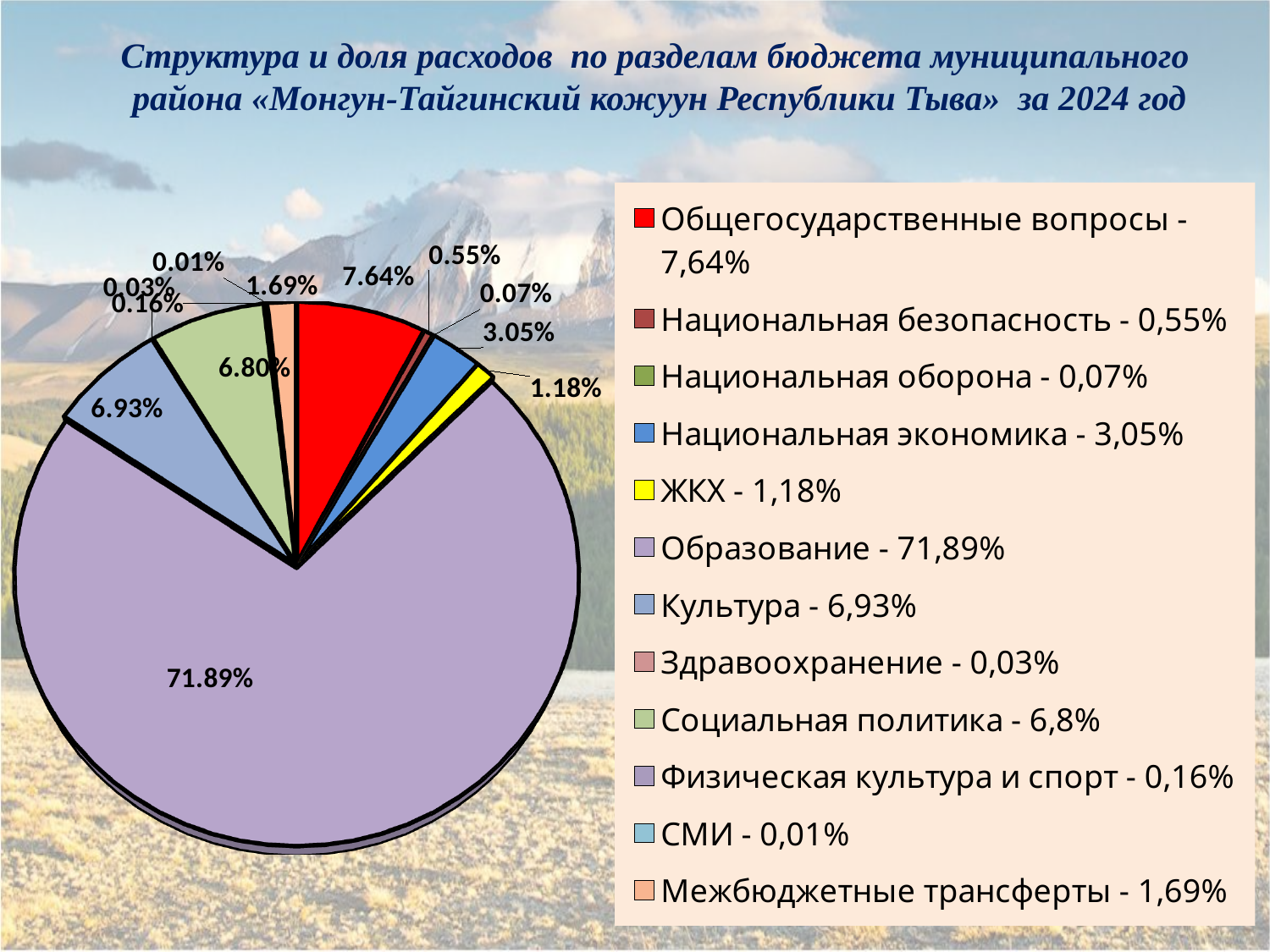
What share of expenditures goes to ЖКХ? 1.18% What is the difference between the shares for Национальная экономика and ЖКХ? 1.87% How many slices (budget sections) does the pie chart have? 12 What share of expenditures goes to Образование? 71.89% What kind of chart is shown on the slide? pie chart By how many percentage points does Общегосударственные вопросы exceed Культура? 0.71% Which budget section has the smallest share of expenditures? СМИ Which is larger: the share for Культура or the share for Социальная политика? Культура What share of expenditures goes to Национальная экономика? 3.05% Which budget section has the largest share of expenditures? Образование What colour is the slice for Образование? purple What share of expenditures goes to Культура? 6.93%